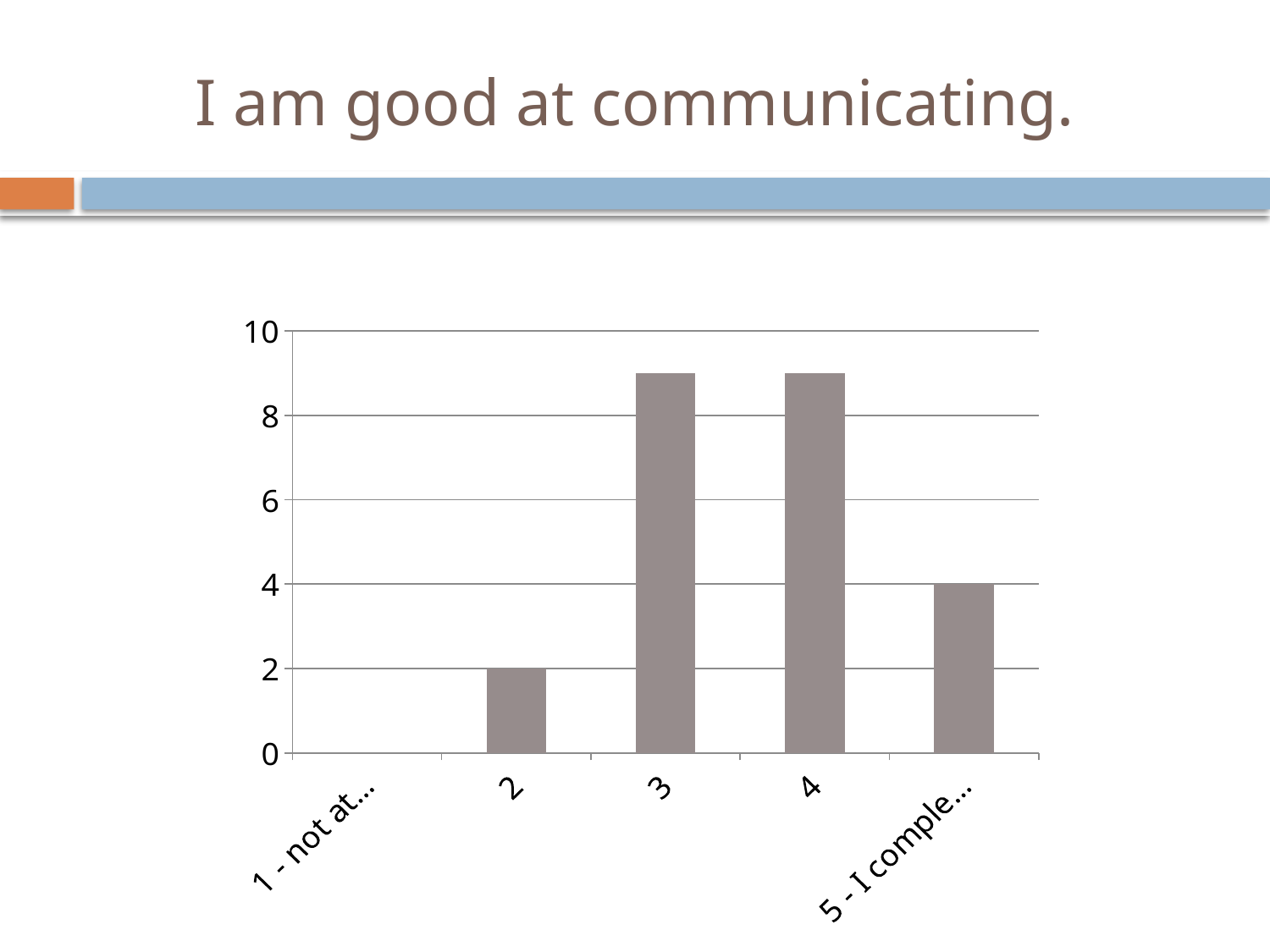
What is the value for category 2? 2 What is the difference between the value for the category labelled "5 - I comple..." and the value for category 2? 2 Which is larger, the value for category 3 or the value for category 2? 3 What is the title of the slide? I am good at communicating. Do the values rise or fall from category 2 to category 3? rise What kind of chart is shown on the slide? bar chart Is the value for category 3 greater or less than 8? greater Is the value for category 4 greater or less than 8? greater What is the value for the category labelled "5 - I comple..."? 4 How many categories are shown on the x axis of the chart? 5 Is the value for category 2 greater or less than 4? less Which is larger, the value for category 4 or the value for the category labelled "5 - I comple..."? 4